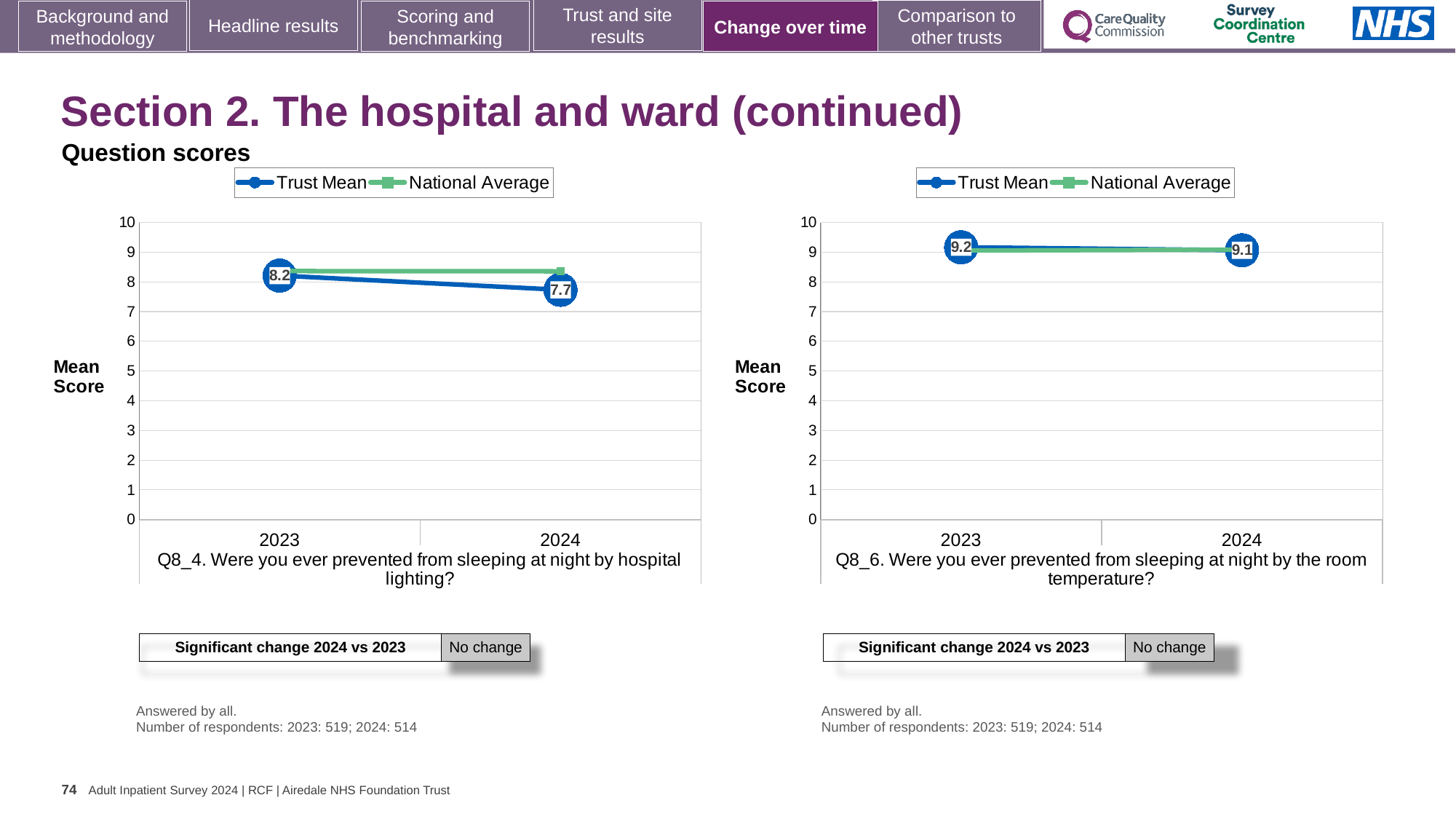
In the Q8_4 chart on the left, does the Trust Mean rise or fall from 2023 to 2024? fall What type of chart is the Q8_4 chart on the left? line chart In the Q8_4 chart on the left, which is higher in 2024, the Trust Mean or the National Average? National Average In the Q8_4 chart on the left, by how much did the Trust Mean fall from 2023 to 2024? 0.5 In the Q8_4 chart on the left, what is the Trust Mean value for 2023? 8.2 How many series does the legend of the Q8_6 chart on the right list? 2 In the Q8_4 chart on the left, what is the Trust Mean value for 2024? 7.7 In the Q8_6 chart on the right, what is the Trust Mean value for 2023? 9.2 In the Q8_6 chart on the right, what is the Trust Mean value for 2024? 9.1 In the Q8_6 chart on the right, what is the difference between the Trust Mean for 2023 and 2024? 0.1 In the Q8_6 chart on the right, is the National Average for 2023 greater or less than 8? greater In the Q8_4 chart on the left, is the National Average for 2024 greater or less than 8? greater